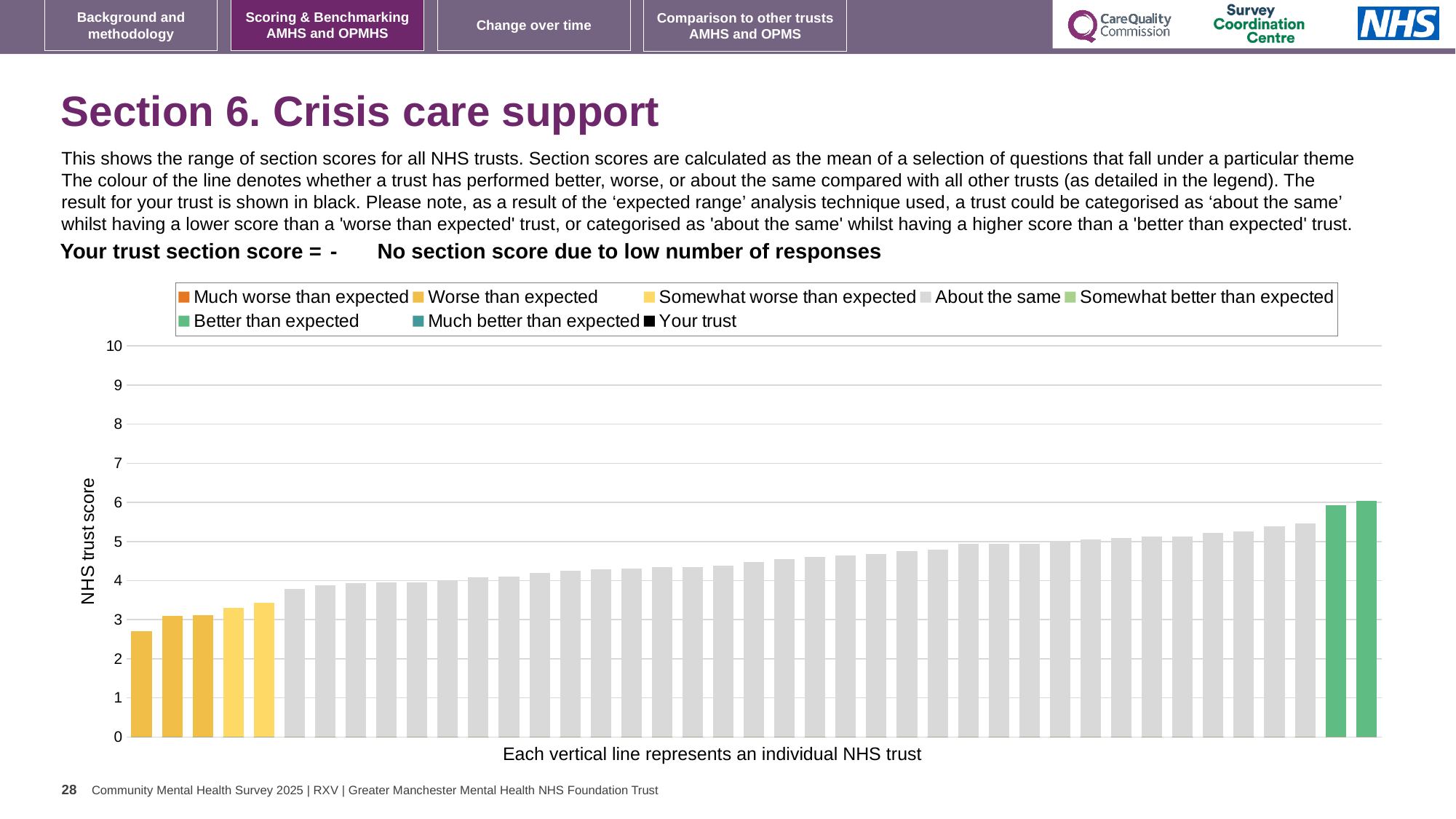
What is the highest value shown on the vertical axis of the chart? 10 How many entries does the chart legend list? 8 Is the value of the lowest bar in the chart greater or less than 3? less Is the value of the tallest bar in the chart greater or less than 5? greater Which legend category do the two tallest bars belong to? Better than expected How many bars are coloured in the 'Worse than expected' or 'Somewhat worse than expected' colours? 5 Do the bar values rise or fall from left to right across the chart? rise What is the label of the vertical axis of the chart? NHS trust score Is the value of the tallest grey ('About the same') bar greater or less than 5? greater What kind of chart is shown on the slide? bar chart How many bars are coloured green ('Better than expected') in the chart? 2